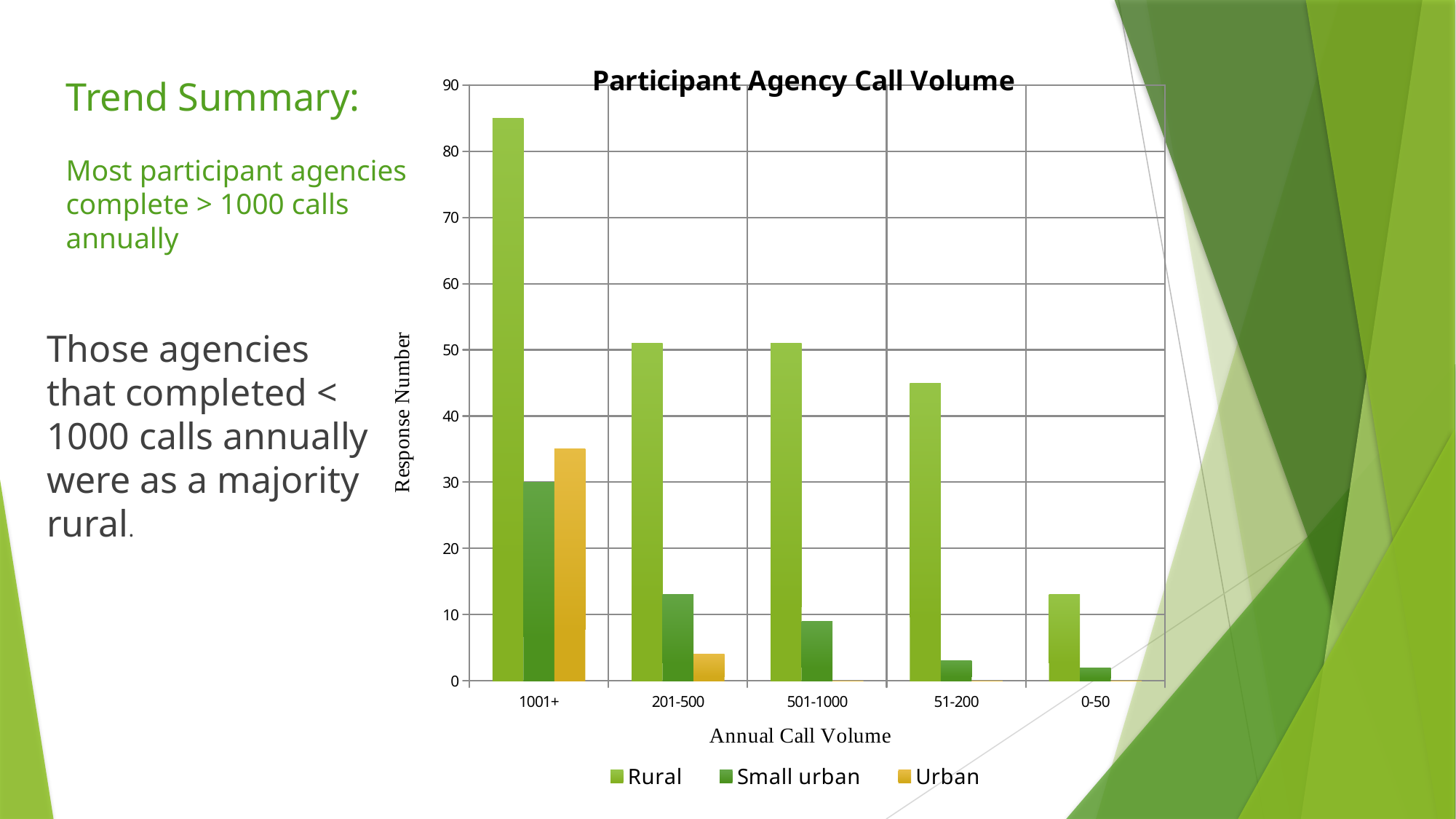
Is the Urban value for 1001+ greater or less than 30? greater How many series does the legend list? 3 How many call volume categories are shown on the x axis? 5 Is the Rural value for 1001+ greater or less than 80? greater What is the label of the y axis? Response Number Which call volume category has the highest Rural response number? 1001+ Is the Small urban value for 201-500 greater or less than 20? less What kind of chart is shown on the slide? bar chart Which call volume category has the lowest Rural response number? 0-50 What is the title of the chart? Participant Agency Call Volume Which is larger: the Rural value for 51-200 or the Rural value for 0-50? 51-200 For the 1001+ category, which is larger: the Small urban value or the Urban value? Urban